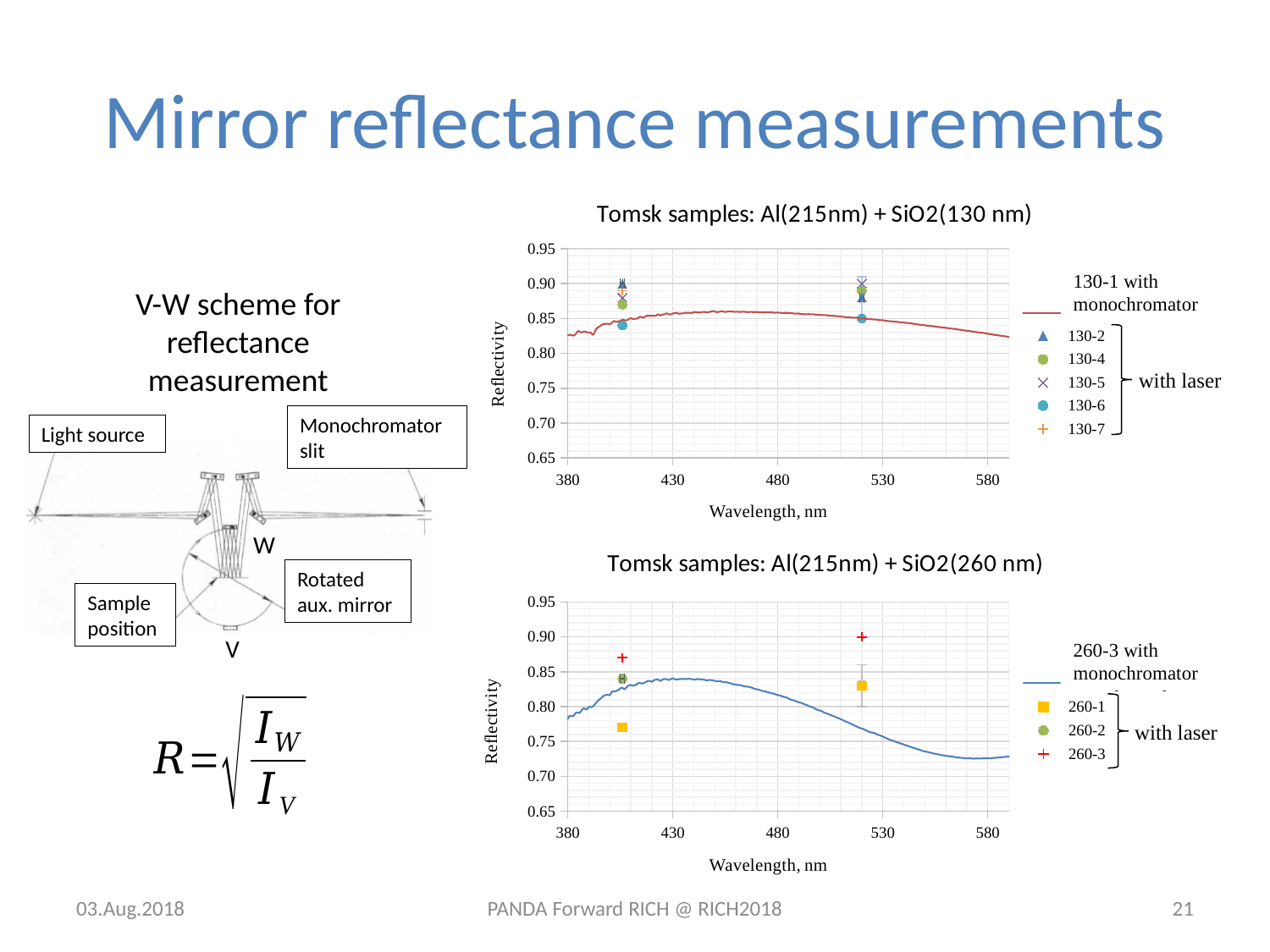
How many series does the legend of the top chart (SiO2 130 nm) list? 6 In the bottom chart (SiO2 260 nm), does the 260-3 monochromator curve rise or fall between 480 nm and 560 nm? fall In the bottom chart (SiO2 260 nm), is the value for 260-1 at about 405 nm greater or less than 0.80? less What kind of chart is the top chart titled "Tomsk samples: Al(215nm) + SiO2(130 nm)"? Scatter chart with a line In the bottom chart (SiO2 260 nm), at about 520 nm, which is larger: the 260-3 laser point or the 260-1 point? 260-3 What is the y-axis label of the bottom chart (SiO2 260 nm)? Reflectivity How many series does the legend of the bottom chart (SiO2 260 nm) list? 4 In the top chart (SiO2 130 nm), at about 405 nm, which is larger: the 130-2 point or the 130-6 point? 130-2 In the top chart (SiO2 130 nm), which series was measured with the monochromator? 130-1 In the top chart (SiO2 130 nm), is the value for 130-2 at about 405 nm greater or less than 0.85? greater In the bottom chart (SiO2 260 nm), is the value for 260-3 (laser point) at about 520 nm greater or less than 0.85? greater In the top chart (SiO2 130 nm), does the 130-1 monochromator curve rise or fall between 380 nm and 450 nm? rise